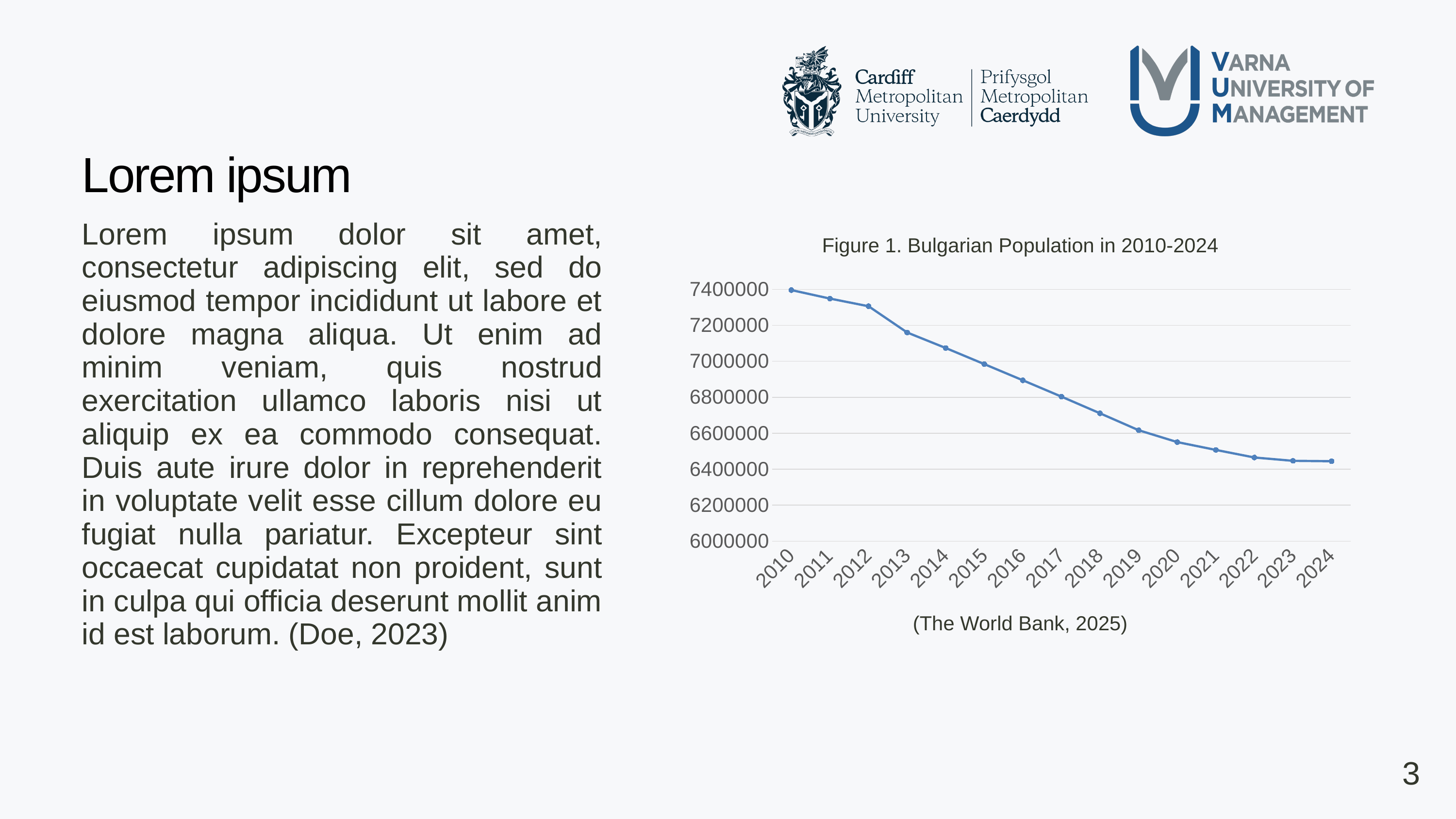
How many years are plotted on the x axis of the chart? 15 What source is cited below the chart? (The World Bank, 2025) Is the value for 2024 greater or less than 6400000? greater Which year has the larger population value, 2012 or 2016? 2012 Is the value for 2013 greater or less than 7200000? less What kind of chart is shown on the slide? line chart Does the Bulgarian population rise or fall from 2010 to 2024 in the chart? fall Is the value for 2011 greater or less than 7200000? greater What is the title of the chart? Figure 1. Bulgarian Population in 2010-2024 Which year has the highest population value in the chart? 2010